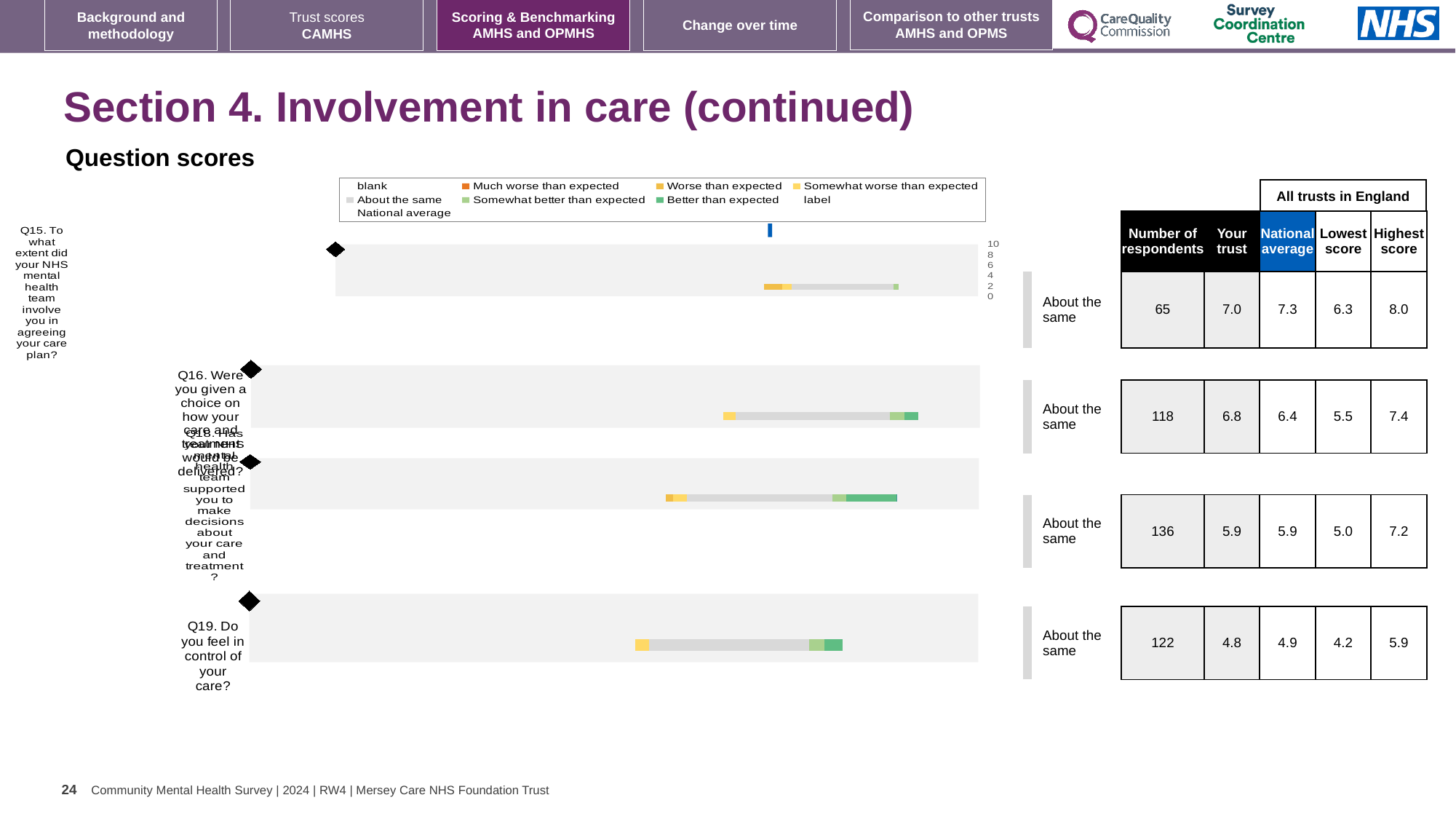
For Q18, what is the difference between the 'Your trust' score and the national average? 0.0 Which question has the highest 'Your trust' score? Q15 What is the title shown above the chart on this slide? Question scores How many respondents answered Q16 (choice on how care and treatment would be delivered)? 118 How many survey questions are plotted in the question scores chart? 4 Which question has the lowest 'Your trust' score? Q19 What benchmark category is shown for Q18 (support to make decisions about care and treatment)? About the same What is the 'Your trust' score for Q15 (involvement in agreeing your care plan)? 7.0 For Q15, what is the difference between the highest score and the lowest score across all trusts in England? 1.7 What is the national average score for Q19 (feeling in control of your care)? 4.9 What kind of chart is used to show the question scores on this slide? Bar chart For Q16, which is larger: the 'Your trust' score or the national average? Your trust